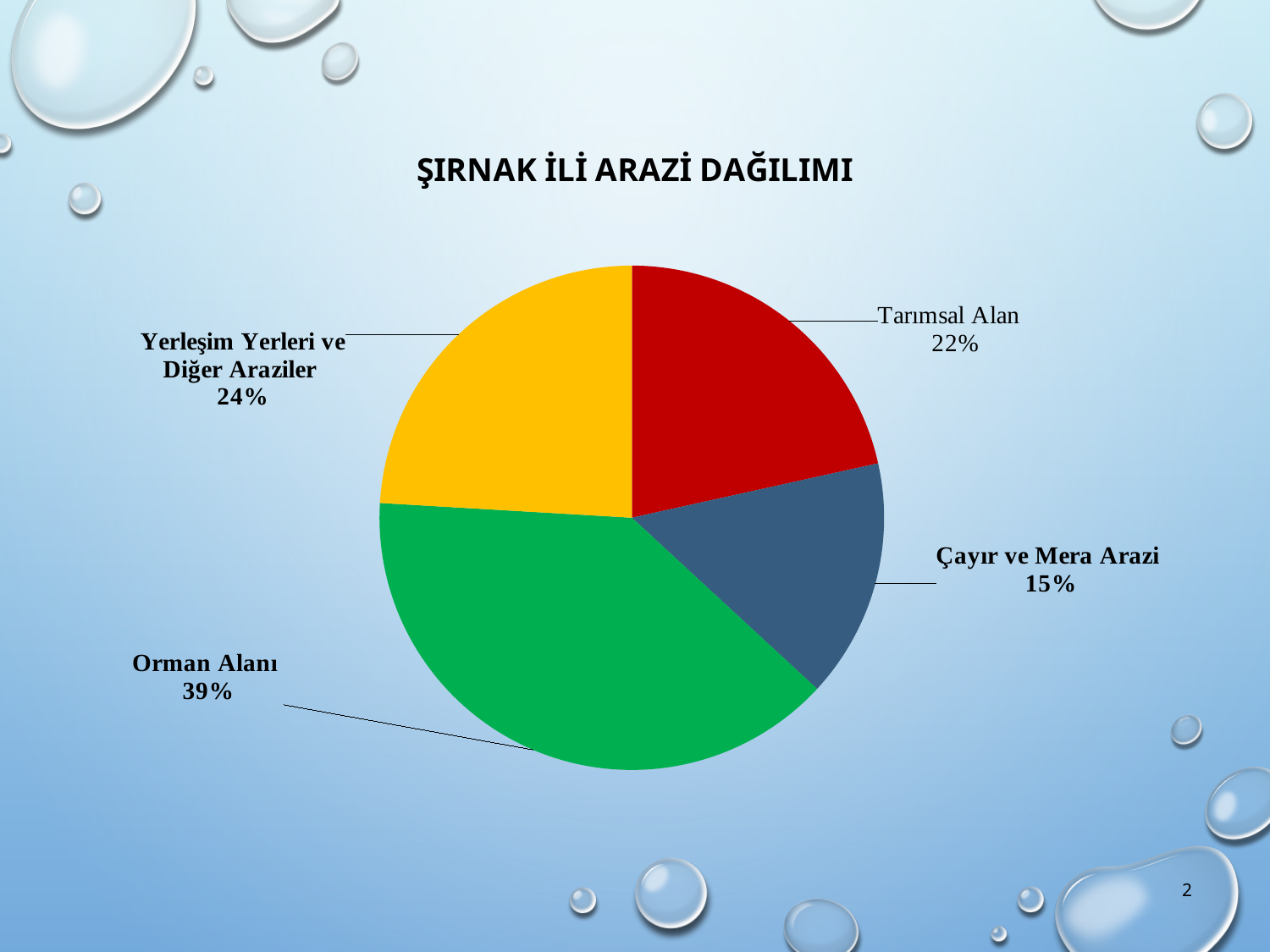
What share of the pie does Orman Alanı represent? 39% What is the value shown for Yerleşim Yerleri ve Diğer Araziler? 24% What is the title of the chart? ŞIRNAK İLİ ARAZİ DAĞILIMI How many categories are shown in the pie chart? 4 Which category has the smallest share of the pie? Çayır ve Mera Arazi Which category has the largest share of the pie? Orman Alanı What is the difference in percentage points between Yerleşim Yerleri ve Diğer Araziler and Çayır ve Mera Arazi? 9 Which is larger, the share for Tarımsal Alan or the share for Yerleşim Yerleri ve Diğer Araziler? Yerleşim Yerleri ve Diğer Araziler What is the difference in percentage points between Orman Alanı and Tarımsal Alan? 17 What kind of chart is shown on the slide? Pie chart What is the value shown for Çayır ve Mera Arazi? 15% What is the value shown for Tarımsal Alan? 22%